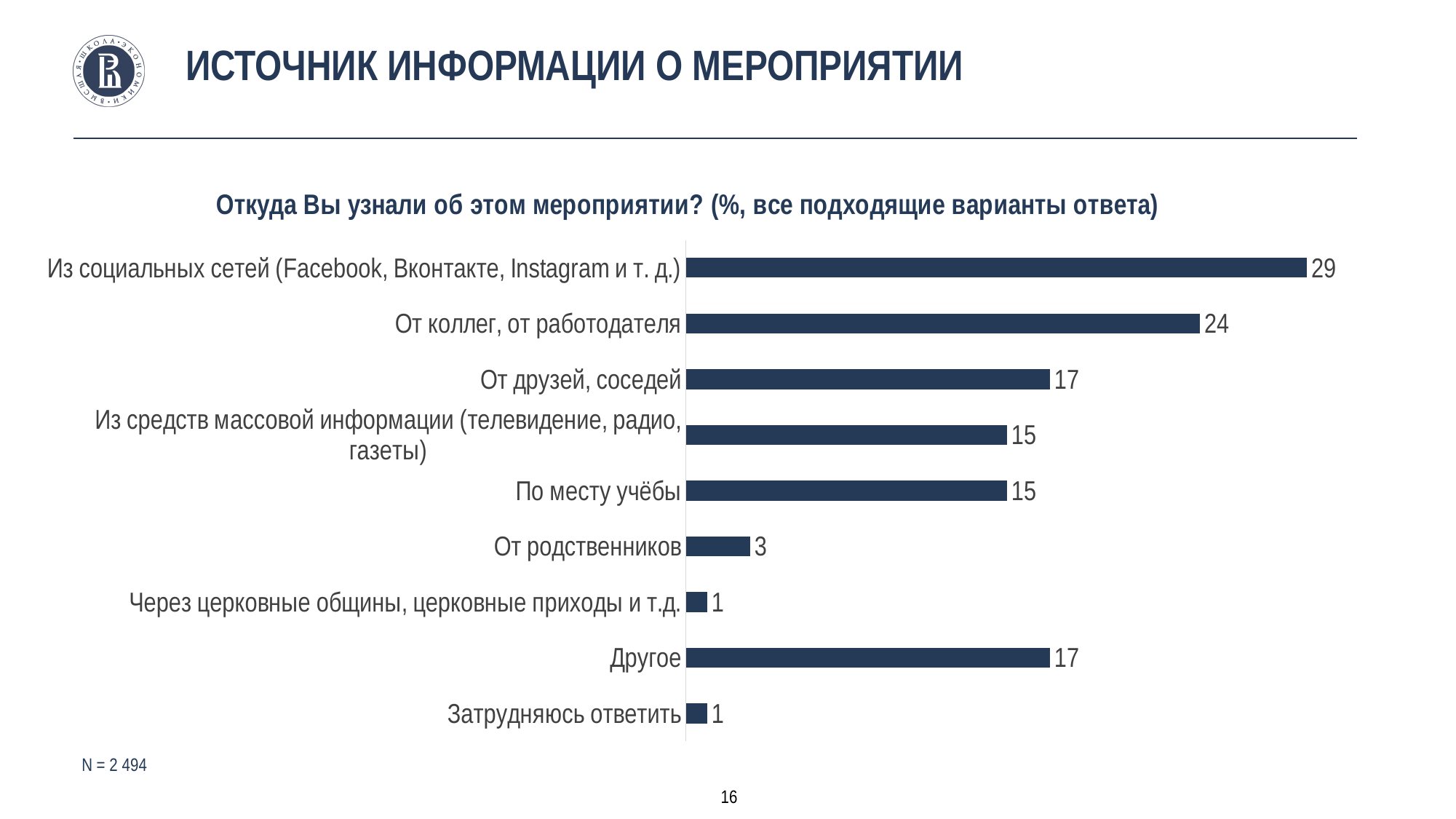
Which category has the highest value? Из социальных сетей (Facebook, Вконтакте, Instagram и т. д.) What is the value for "По месту учёбы"? 15 What is the value for "Другое"? 17 What is the value for "От коллег, от работодателя"? 24 What is the value for "От родственников"? 3 Which is larger: the value for "От друзей, соседей" or the value for "От родственников"? От друзей, соседей What is the difference between the values for "От друзей, соседей" and "Из средств массовой информации (телевидение, радио, газеты)"? 2 What kind of chart is shown on the slide? Bar chart What is the title of the chart? Откуда Вы узнали об этом мероприятии? (%, все подходящие варианты ответа) What is the difference between the values for "Из социальных сетей (Facebook, Вконтакте, Instagram и т. д.)" and "От коллег, от работодателя"? 5 How many categories are shown in the chart? 9 What is the value for "Из социальных сетей (Facebook, Вконтакте, Instagram и т. д.)"? 29